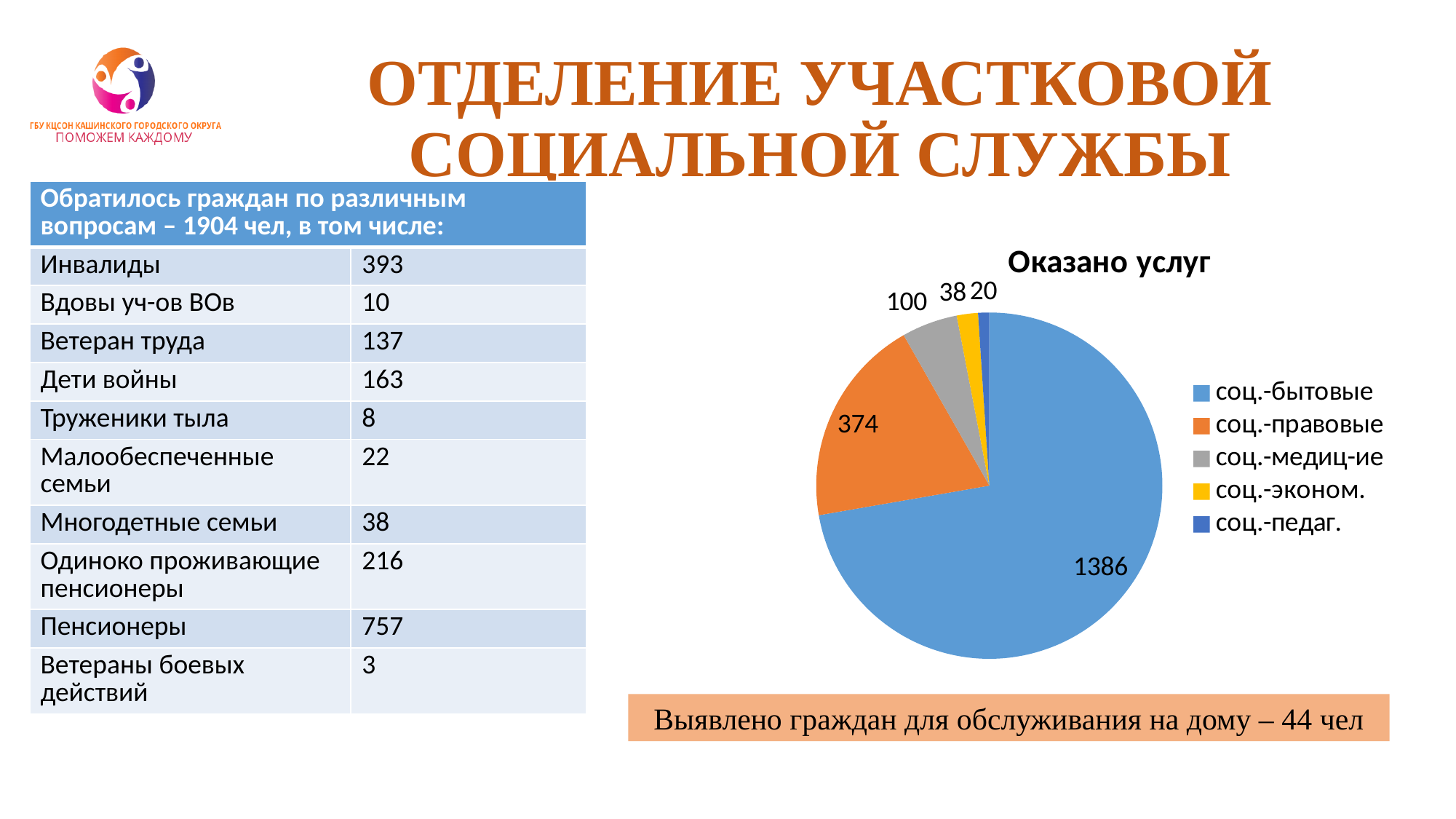
What is the value for соц.-бытовые in the pie chart? 1386 What kind of chart is shown on the slide? pie chart How many entries does the chart legend list? 5 What is the title of the chart? Оказано услуг Which category has the smallest slice in the pie chart? соц.-педаг. Which is larger, the value for соц.-медиц-ие or the value for соц.-эконом.? соц.-медиц-ие What is the value for соц.-медиц-ие in the pie chart? 100 How many slices does the pie chart have? 5 What is the value for соц.-правовые in the pie chart? 374 Which category has the largest slice in the pie chart? соц.-бытовые What is the value for соц.-педаг. in the pie chart? 20 What is the difference between the values for соц.-бытовые and соц.-правовые? 1012